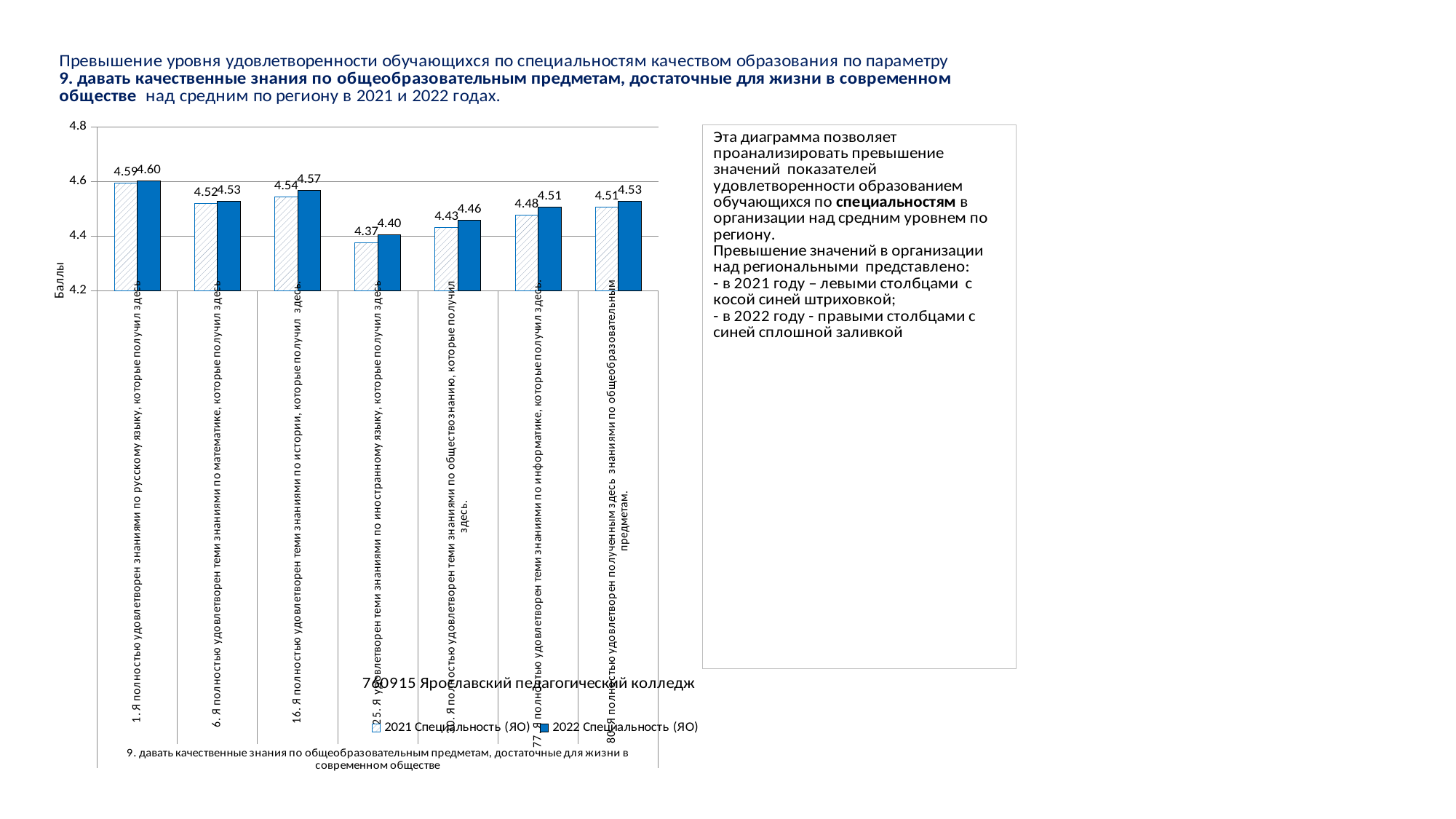
Which category has the lowest 2022 Специальность (ЯО) value? 25. Я удовлетворен теми знаниями по иностранному языку, которые получил здесь What is the 2021 Специальность (ЯО) value for the category about knowledge of history (16. ...по истории...)? 4.54 Is the 2021 Специальность (ЯО) value for the category about informatics (77. ...по информатике...) greater or less than 4.4? greater Which category has the highest 2021 Специальность (ЯО) value? 1. Я полностью удовлетворен знаниями по русскому языку, которые получил здесь What kind of chart is shown on the slide? bar chart What is the label of the vertical axis of the chart? Баллы What is the 2021 Специальность (ЯО) value for the category about knowledge of foreign language (25. ...по иностранному языку...)? 4.37 What is the difference between the 2022 and 2021 values for the category about knowledge of history (16. ...по истории...)? 0.03 How many series does the chart legend list? 2 What is the 2022 Специальность (ЯО) value for the category about knowledge of Russian language (1. Я полностью удовлетворен теми знаниями по русскому языку...)? 4.60 Which is larger for the category about social studies (50. ...по обществознанию...): the 2021 value or the 2022 value? 2022 value (4.46) How many categories (question items) are plotted on the chart? 7